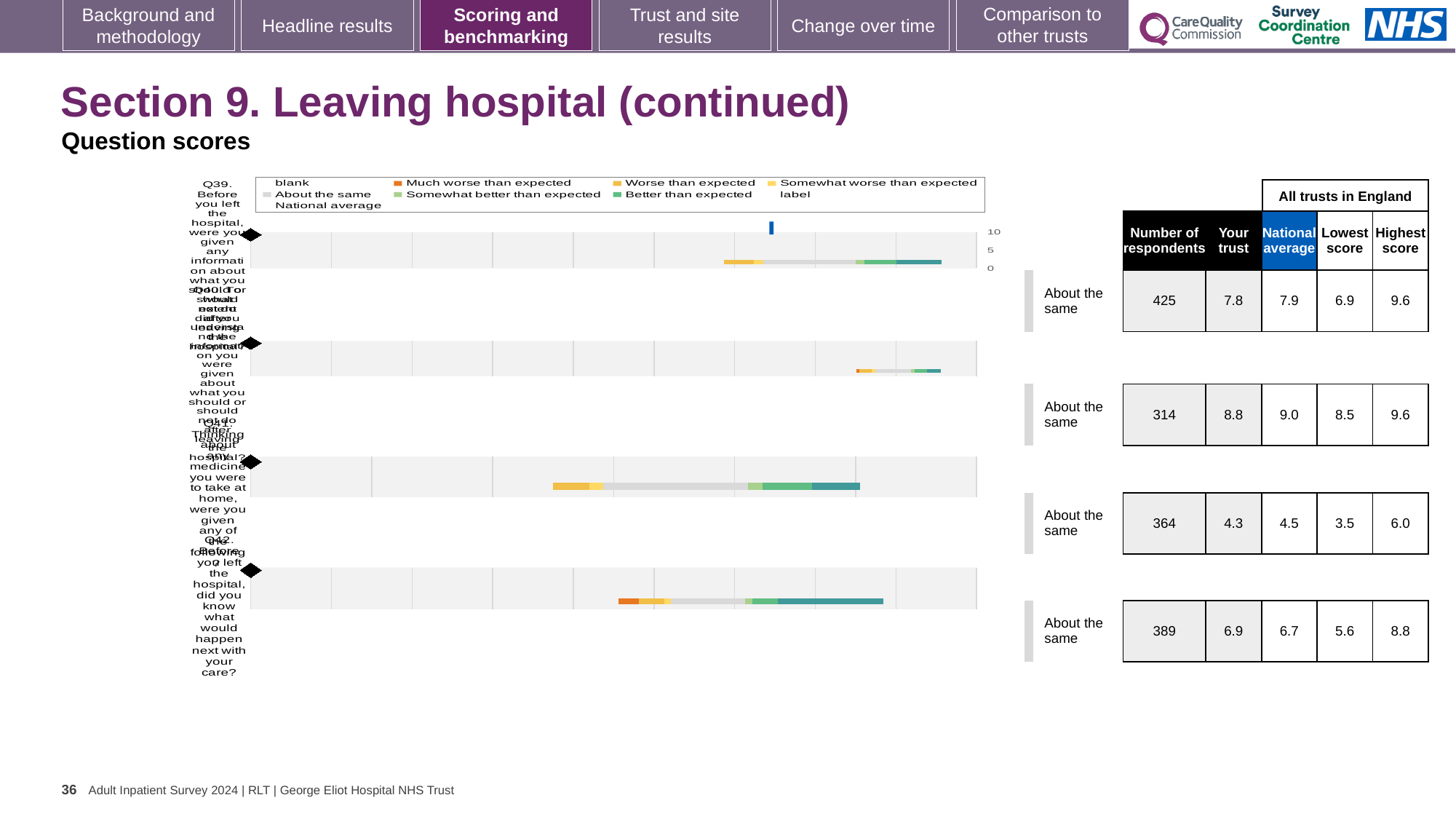
In the table beside the chart, what is the number of respondents in the first row? 425 In the table beside the chart, what is the 'Your trust' score in the first row? 7.8 What kind of chart is shown on the slide? bar chart What is the highest value shown on the chart's x axis? 10 In the table beside the chart, what is the highest score in the third row? 6.0 In the table beside the chart, what is the difference between the 'Your trust' score and the national average in the fourth row? 0.2 How many survey questions (bars) does the chart show? 4 In the table beside the chart, which row has the highest 'Your trust' score? second row (8.8) In the table beside the chart, which is larger in the third row: the 'Your trust' score or the national average? National average What colour represents 'Much worse than expected' in the chart legend? orange In the table beside the chart, what is the lowest number of respondents listed? 314 In the table beside the chart, what is the lowest score in the second row? 8.5